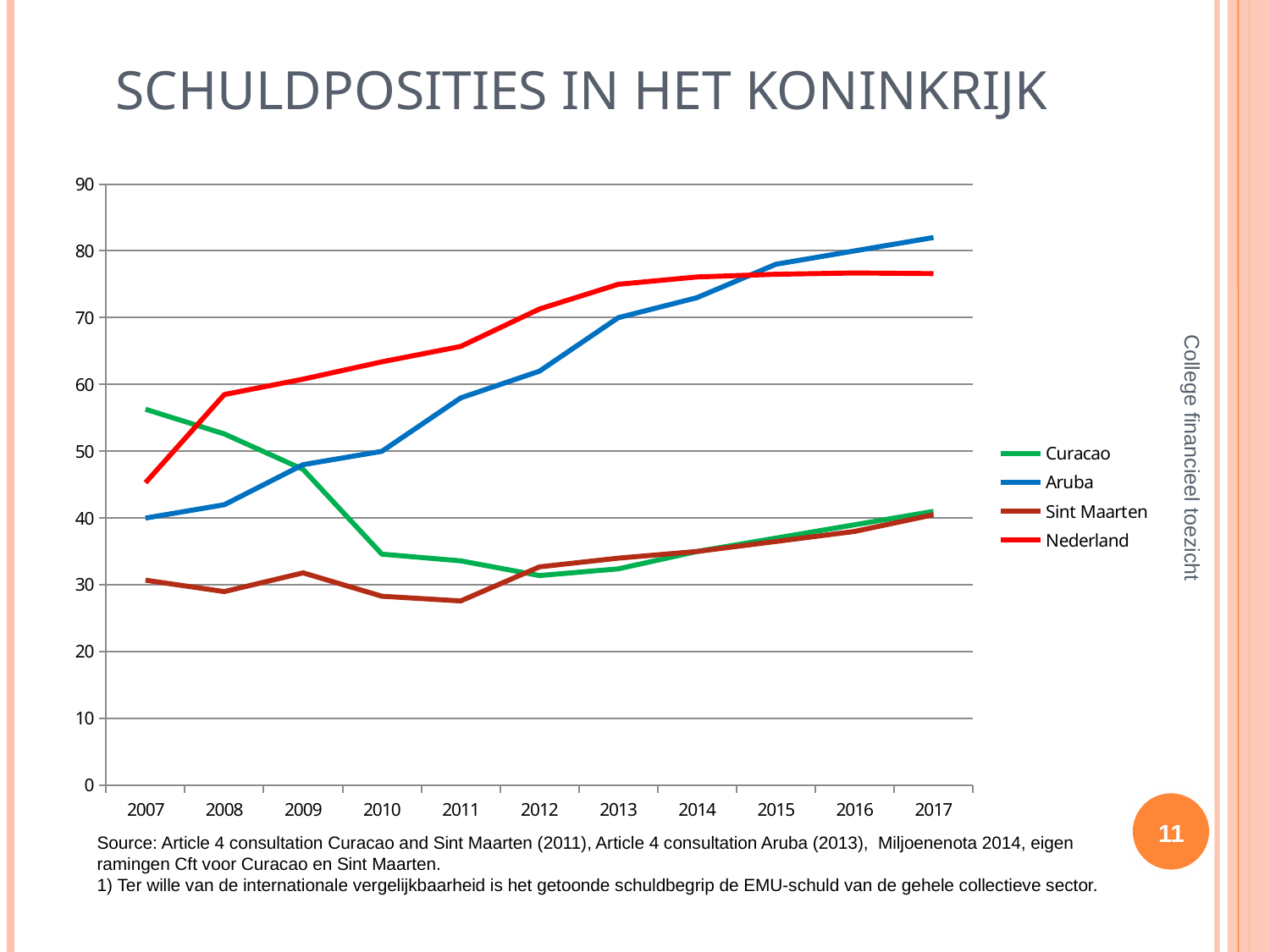
What kind of chart is shown on the slide? line chart In 2008, which is larger: the value for Curacao or the value for Nederland? Nederland What colour is the Nederland line in the legend? red How many series does the legend list? 4 Does the Aruba line rise or fall from 2007 to 2017? rise Which series has the lowest value in 2011? Sint Maarten Is the value for Sint Maarten in 2011 greater or less than 30? less Is the value for Curacao in 2007 greater or less than 50? greater Which series has the highest value in 2017? Aruba Is the value for Nederland in 2007 greater or less than 50? less How many years are shown on the x axis? 11 Which series has the highest value in 2007? Curacao